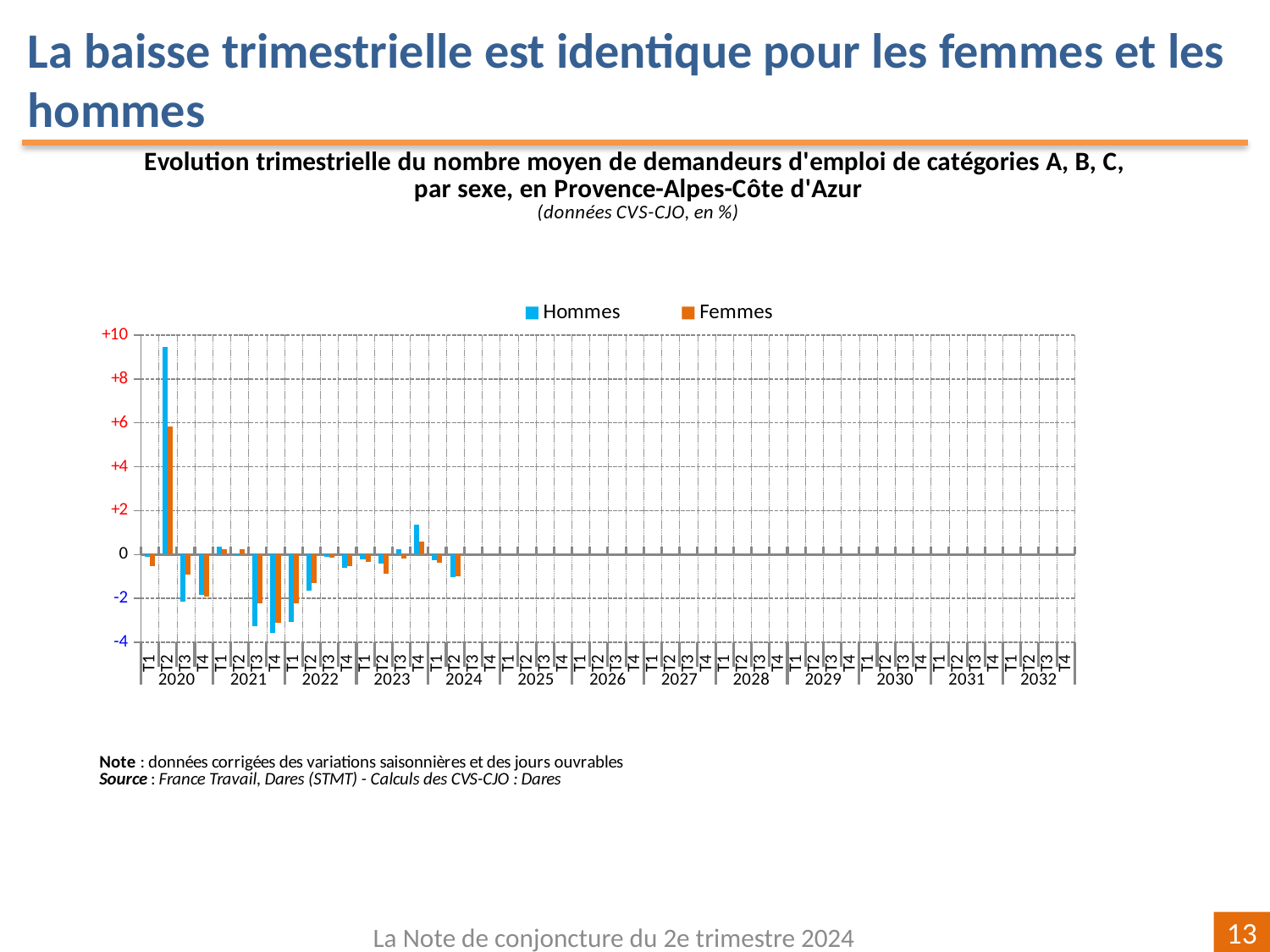
Which two series are shown in the legend? Hommes and Femmes Is the Femmes value for T2 2020 greater or less than +4? greater In T2 2020, which series has the larger value, Hommes or Femmes? Hommes How many years are labelled along the x axis? 13 Is the Hommes value for T4 2023 greater or less than +2? less Is the Hommes value for T4 2021 greater or less than -2? less Which colour represents the Femmes series? Orange In which quarter does the Hommes series reach its highest value? T2 2020 What kind of chart is shown on the slide? Bar chart How many series does the legend list? 2